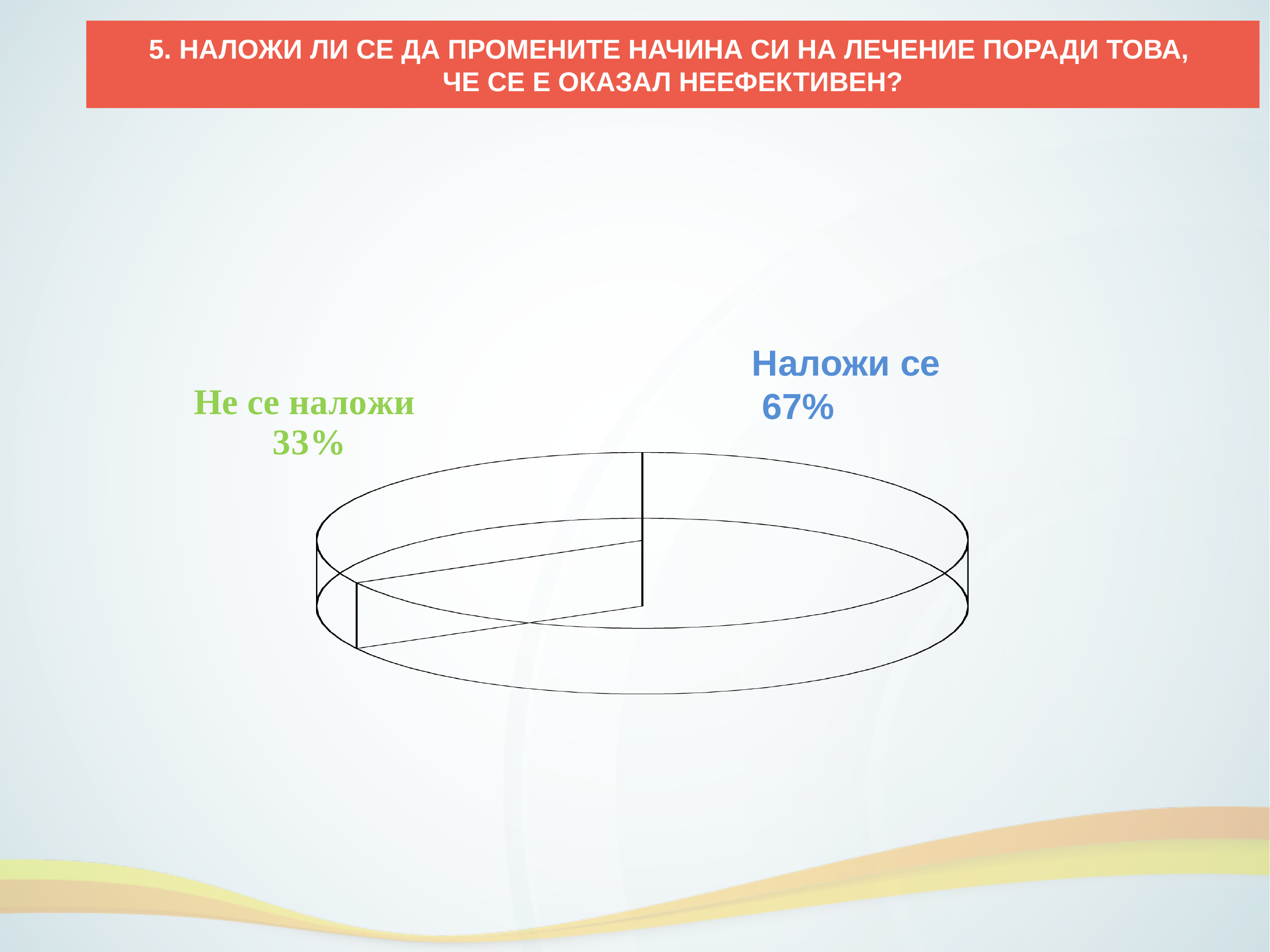
Which category has the smaller share of the pie? Не се наложи What is the difference in percentage points between "Наложи се" and "Не се наложи"? 34 What percentage is shown for "Наложи се"? 67% What kind of chart is shown on the slide? Pie chart What percentage is shown for "Не се наложи"? 33% What is the total of the two percentages shown on the pie chart? 100% Which is larger: the share for "Наложи се" or the share for "Не се наложи"? Наложи се What share of the pie does "Не се наложи" represent? 33% How many categories does the pie chart show? 2 In what colour is the label "Не се наложи 33%" written? Green Which category has the larger share of the pie? Наложи се What is the title of the slide containing the chart? 5. НАЛОЖИ ЛИ СЕ ДА ПРОМЕНИТЕ НАЧИНА СИ НА ЛЕЧЕНИЕ ПОРАДИ ТОВА, ЧЕ СЕ Е ОКАЗАЛ НЕЕФЕКТИВЕН?